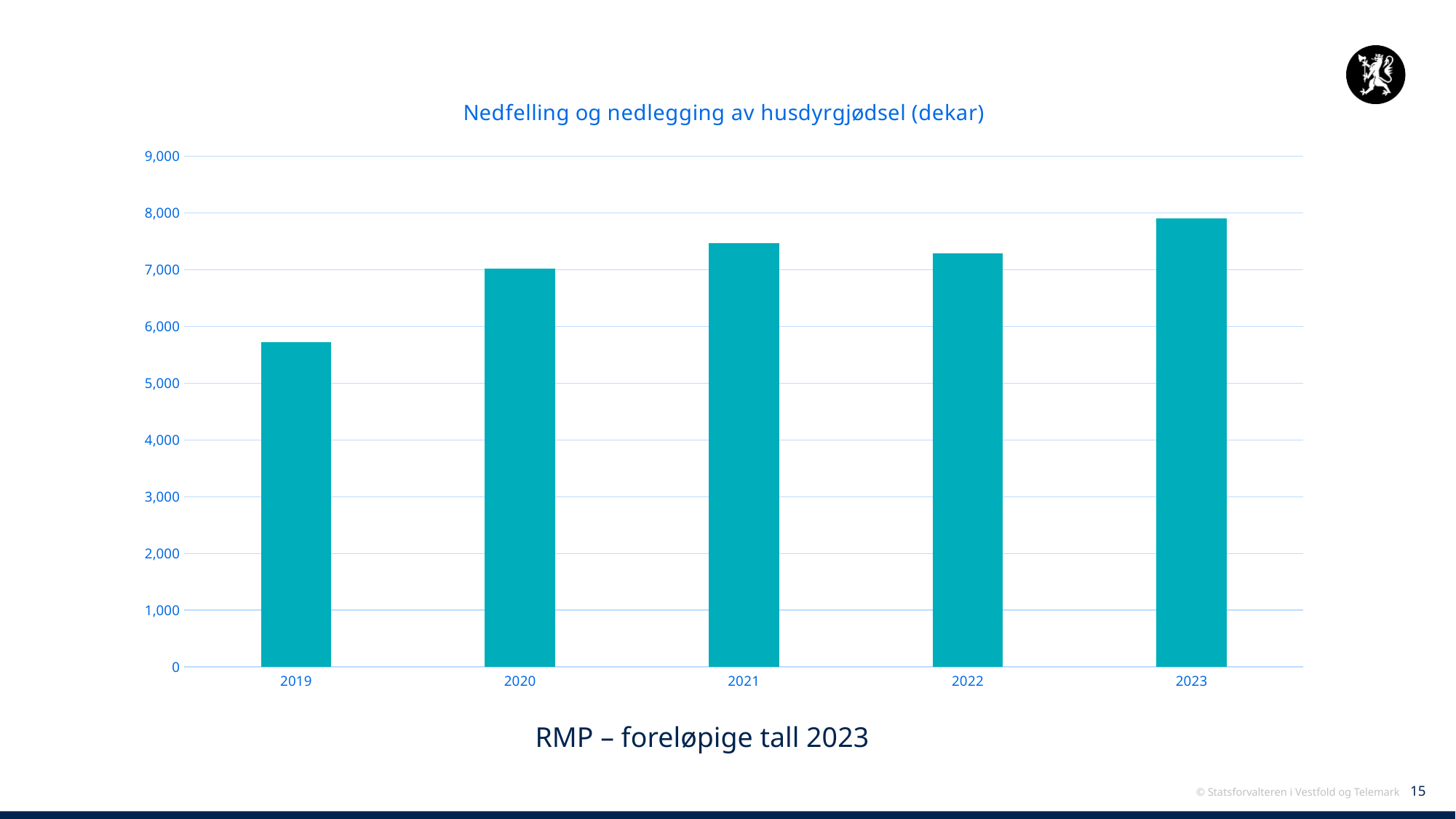
Which is larger, the value for 2020 or the value for 2023? 2023 Is the value for 2023 greater or less than 8,000? less Is the value for 2021 greater or less than 7,000? greater Is the value for 2019 greater or less than 6,000? less Which year has the lowest value in the chart? 2019 Which is larger, the value for 2023 or the value for 2019? 2023 What is the highest value shown on the y axis of the chart? 9,000 What kind of chart is shown on the slide? bar chart What is the title of the chart? Nedfelling og nedlegging av husdyrgjødsel (dekar) Which year has the highest value in the chart? 2023 How many years are shown on the x axis of the chart? 5